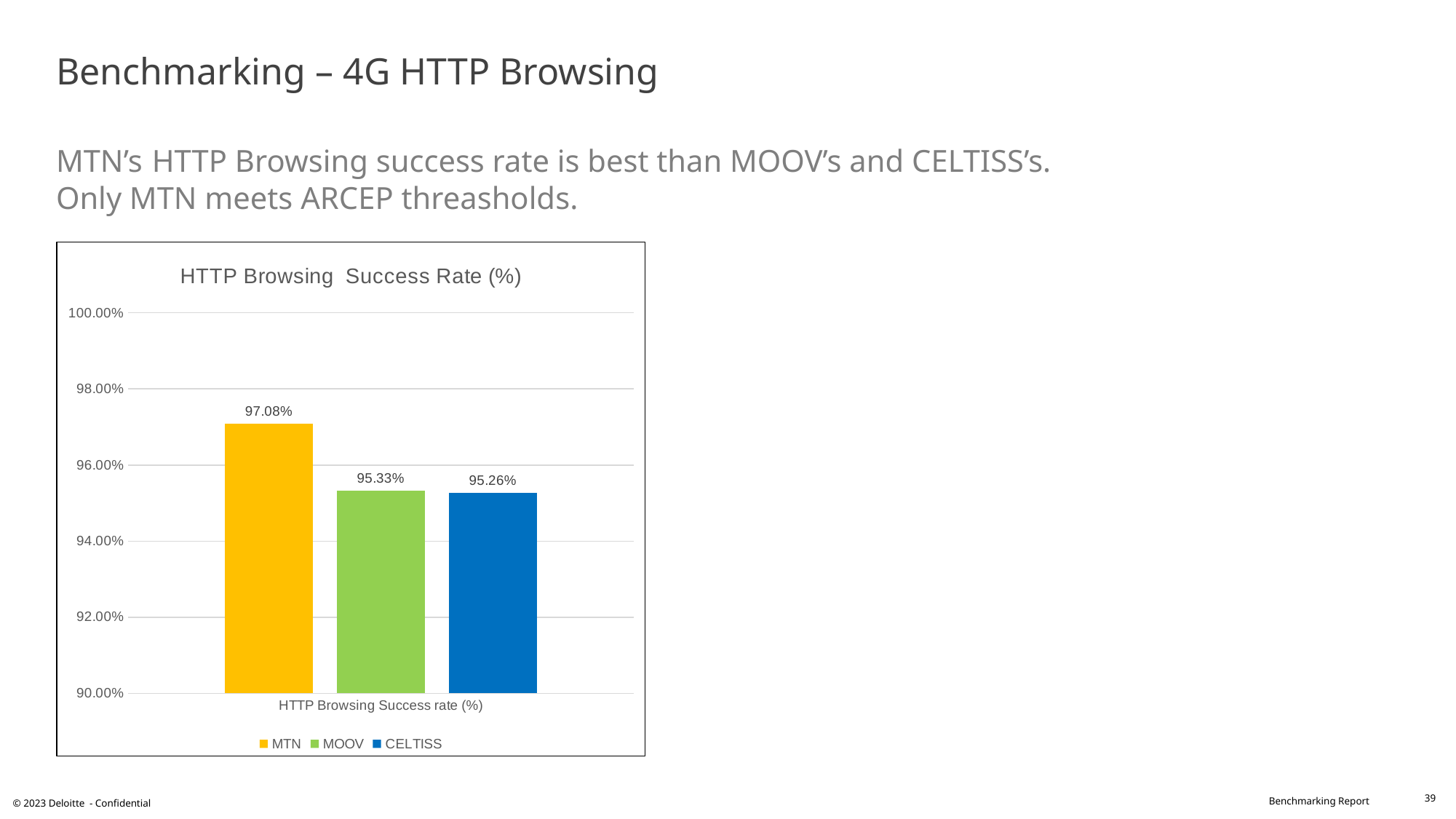
What is the difference between MTN's and MOOV's HTTP Browsing success rates? 1.75% What is the HTTP Browsing success rate for CELTISS? 95.26% Is the value for MTN greater or less than 96.00%? greater What is the HTTP Browsing success rate for MOOV? 95.33% Which operator has the highest HTTP Browsing success rate? MTN Which is larger, the success rate for MTN or for CELTISS? MTN What is the difference between MTN's and CELTISS's HTTP Browsing success rates? 1.82% What is the title of the chart? HTTP Browsing Success Rate (%) How many series does the legend list? 3 What is the HTTP Browsing success rate for MTN? 97.08% Is the value for MOOV greater or less than 96.00%? less What kind of chart is shown on the slide? Bar chart